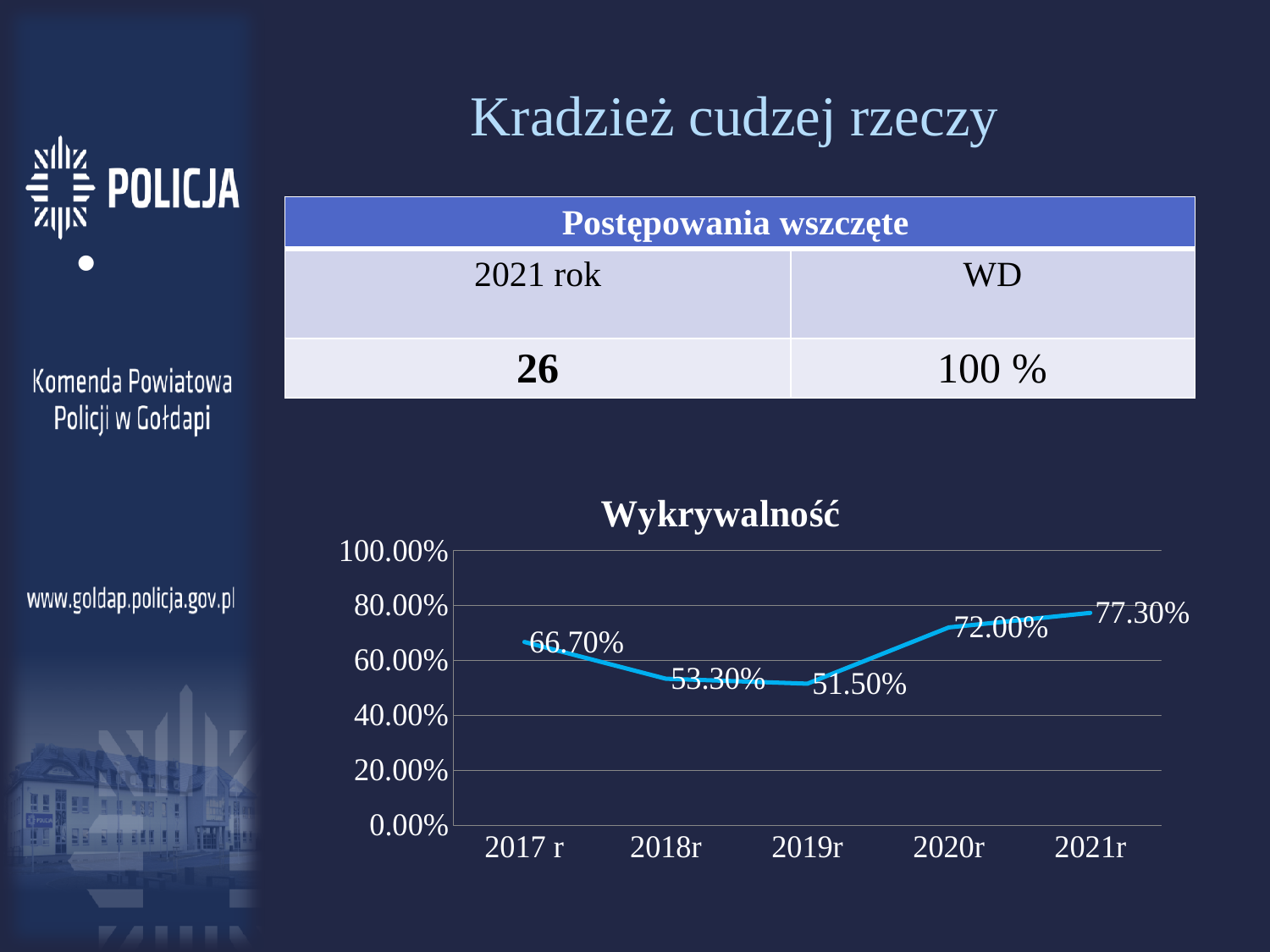
What kind of chart is the Wykrywalność chart? line chart What is the difference between the values for 2021r and 2020r in the Wykrywalność chart? 5.30% Which is larger in the Wykrywalność chart, the value for 2018r or the value for 2020r? 2020r What is the value for 2021r in the Wykrywalność chart? 77.30% Is the value for 2019r in the Wykrywalność chart greater or less than 60.00%? less What is the value for 2019r in the Wykrywalność chart? 51.50% What is the difference between the values for 2017 r and 2018r in the Wykrywalność chart? 13.40% Which year has the lowest value in the Wykrywalność chart? 2019r How many years are plotted in the Wykrywalność chart? 5 Does the value in the Wykrywalność chart rise or fall from 2019r to 2021r? rise What is the value for 2017 r in the Wykrywalność chart? 66.70% Which year has the highest value in the Wykrywalność chart? 2021r